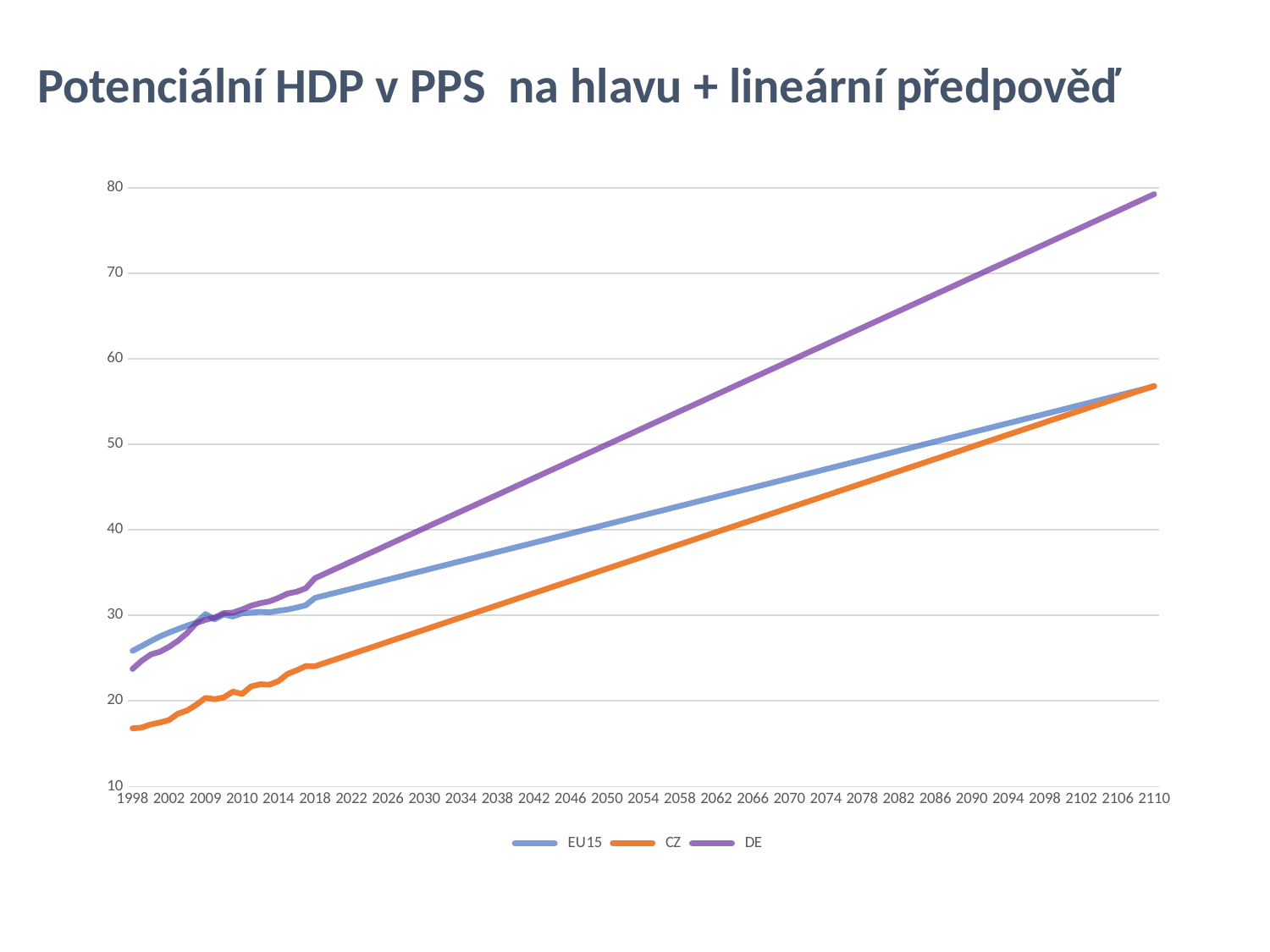
How many series does the legend list? 3 Is the value for CZ at 2110 greater or less than 50? greater Is the value for EU15 at 1998 greater or less than 20? greater At 1998, which is larger: the value for EU15 or the value for CZ? EU15 What kind of chart is shown on the slide? line chart Is the value for DE at 2110 greater or less than 70? greater At 2110, which is larger: the value for DE or the value for CZ? DE Which series has the highest value at 2110? DE What is the title of the chart? Potenciální HDP v PPS na hlavu + lineární předpověď Do the values for DE rise or fall from 1998 to 2110? rise Which series has the lowest value at 1998? CZ